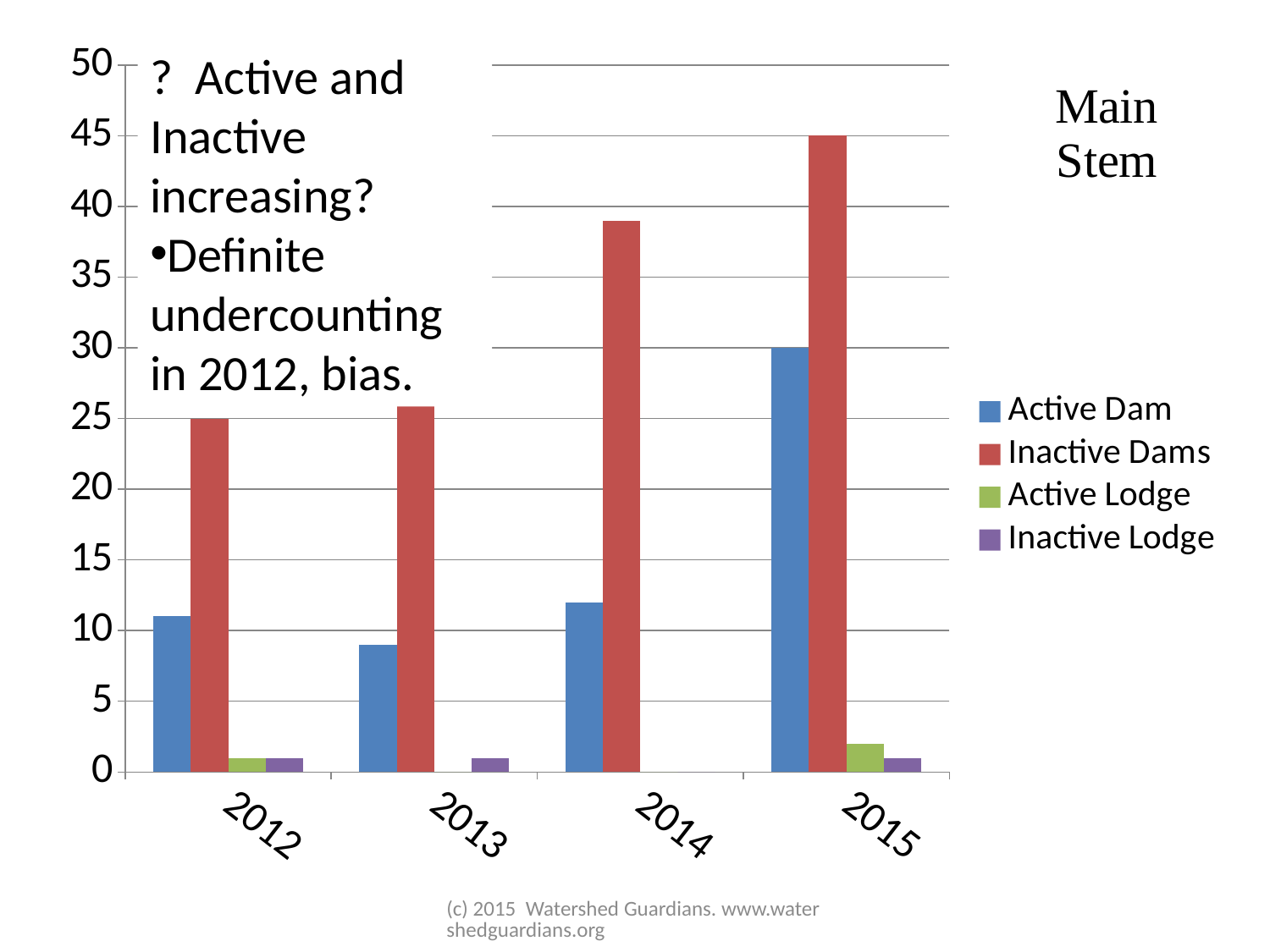
What is the value for Inactive Dams in 2015? 45 What is the value for Active Dam in 2015? 30 How many series does the legend list? 4 What type of chart is shown on the slide? bar chart Is the value for Active Dam in 2013 greater or less than 10? less In which year is the Inactive Dams value highest? 2015 What is the value for Inactive Dams in 2012? 25 Is the value for Inactive Dams in 2014 greater or less than 35? greater What is the difference between Inactive Dams and Active Dam in 2015? 15 Do the Inactive Dams values rise or fall from 2012 to 2015? rise How many years are shown on the x axis? 4